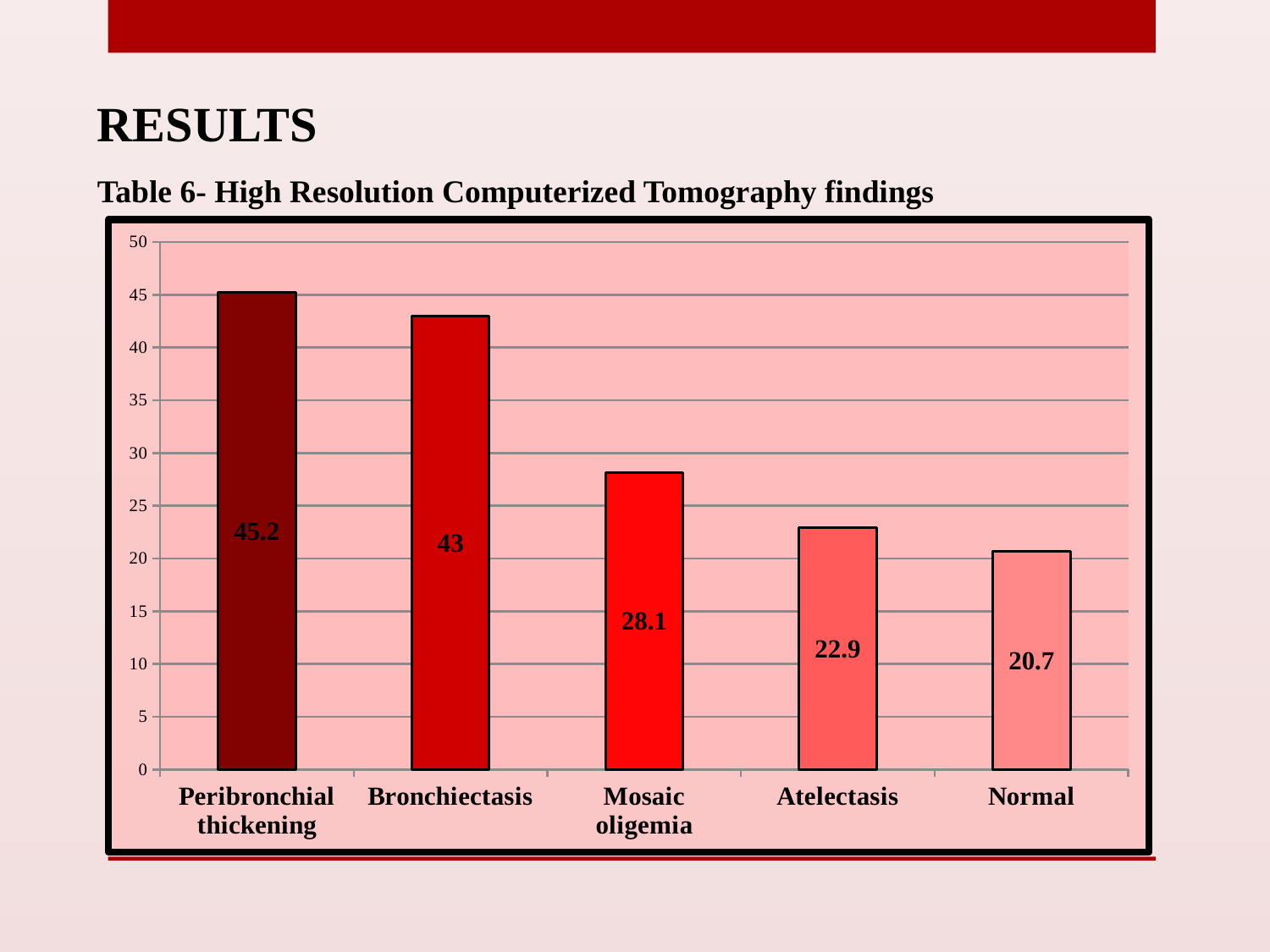
What is the value for Peribronchial thickening? 45.2 Which category has the lowest value? Normal What is the value for Normal? 20.7 What is the value for Mosaic oligemia? 28.1 How many categories are shown on the x axis? 5 Is the value for Bronchiectasis greater or less than 40? greater Which category has the highest value? Peribronchial thickening What is the difference between the values for Bronchiectasis and Atelectasis? 20.1 Do the values rise or fall from left to right along the x axis? fall What kind of chart is shown on the slide? bar chart What is the title of the chart? Table 6- High Resolution Computerized Tomography findings Which is larger, the value for Mosaic oligemia or the value for Atelectasis? Mosaic oligemia